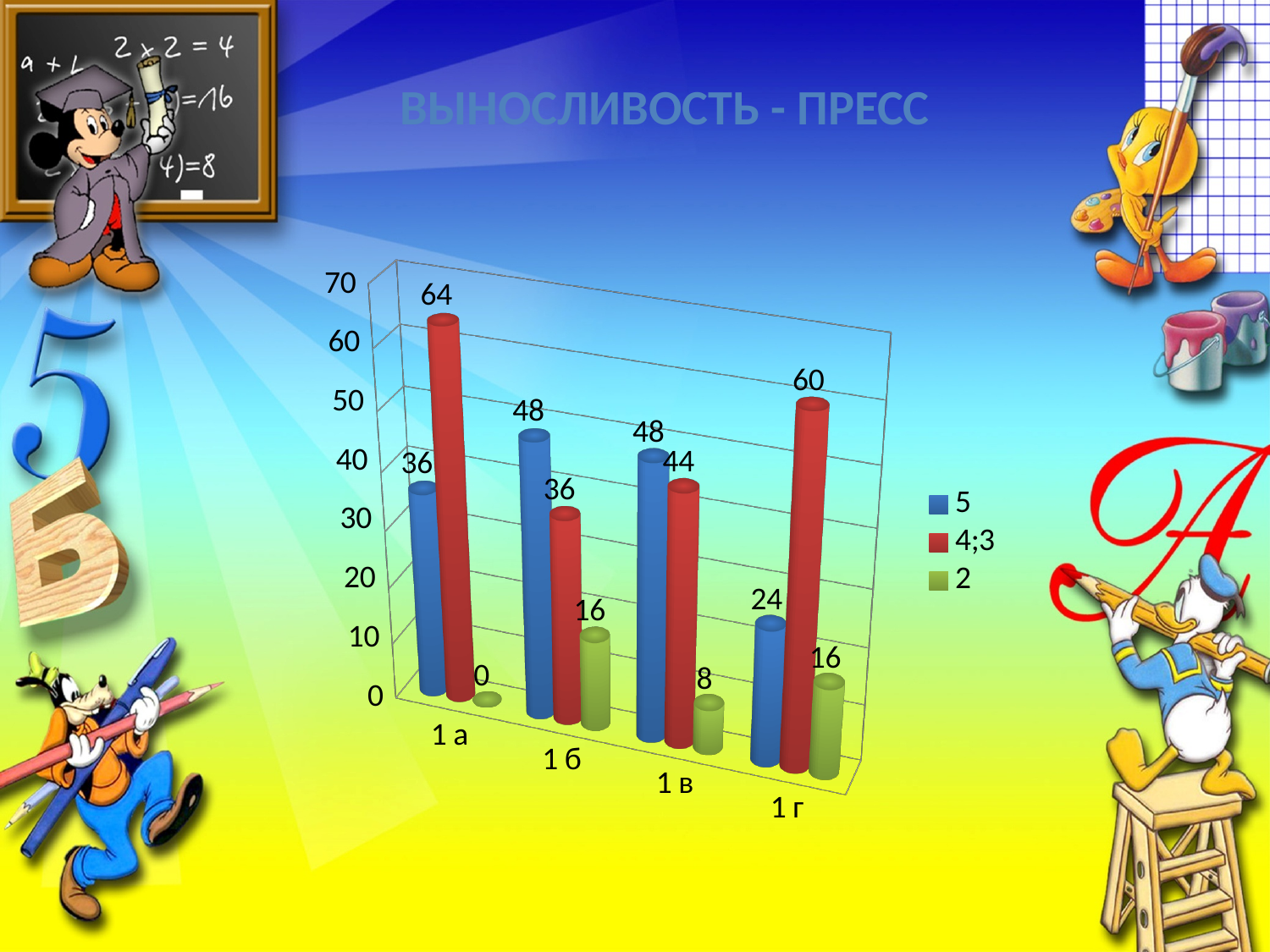
What kind of chart is shown on the slide? bar chart Which category has the lowest value for series "5"? 1 г What is the value for series "5" in category "1 г"? 24 In category "1 в", which is larger: the value for series "5" or series "4;3"? 5 Which category has the highest value for series "4;3"? 1 а What is the title of the chart? ВЫНОСЛИВОСТЬ - ПРЕСС What is the difference between the "4;3" value and the "5" value in category "1 г"? 36 What is the value for series "2" in category "1 в"? 8 What is the value for series "4;3" in category "1 а"? 64 How many series does the legend list? 3 What is the value for series "4;3" in category "1 б"? 36 How many categories are shown on the x axis? 4